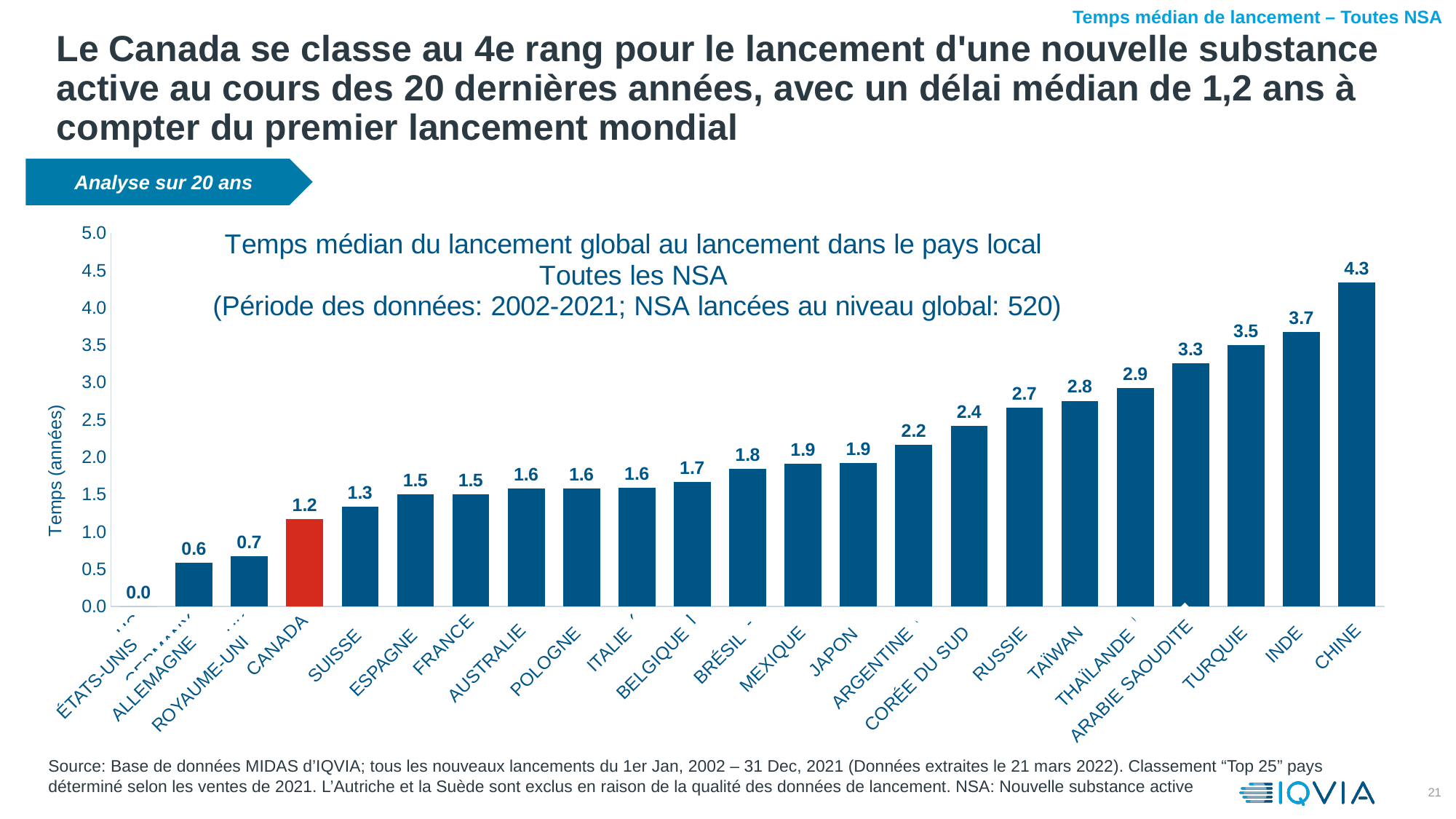
What is the median launch time shown for Canada? 1.2 What is the difference between the values for Inde and Canada? 2.5 Which country has the lowest median launch time? États-Unis Which country's bar is highlighted in red? Canada What kind of chart is shown on the slide? Bar chart Is the value for Arabie Saoudite greater or less than 3.0? greater Do the values rise or fall from left to right along the x axis? Rise How many countries are shown in the chart? 23 Which has a larger value, Turquie or Russie? Turquie What value is shown for Chine (China)? 4.3 What value is shown for Japon (Japan)? 1.9 Which country has the highest median launch time? Chine